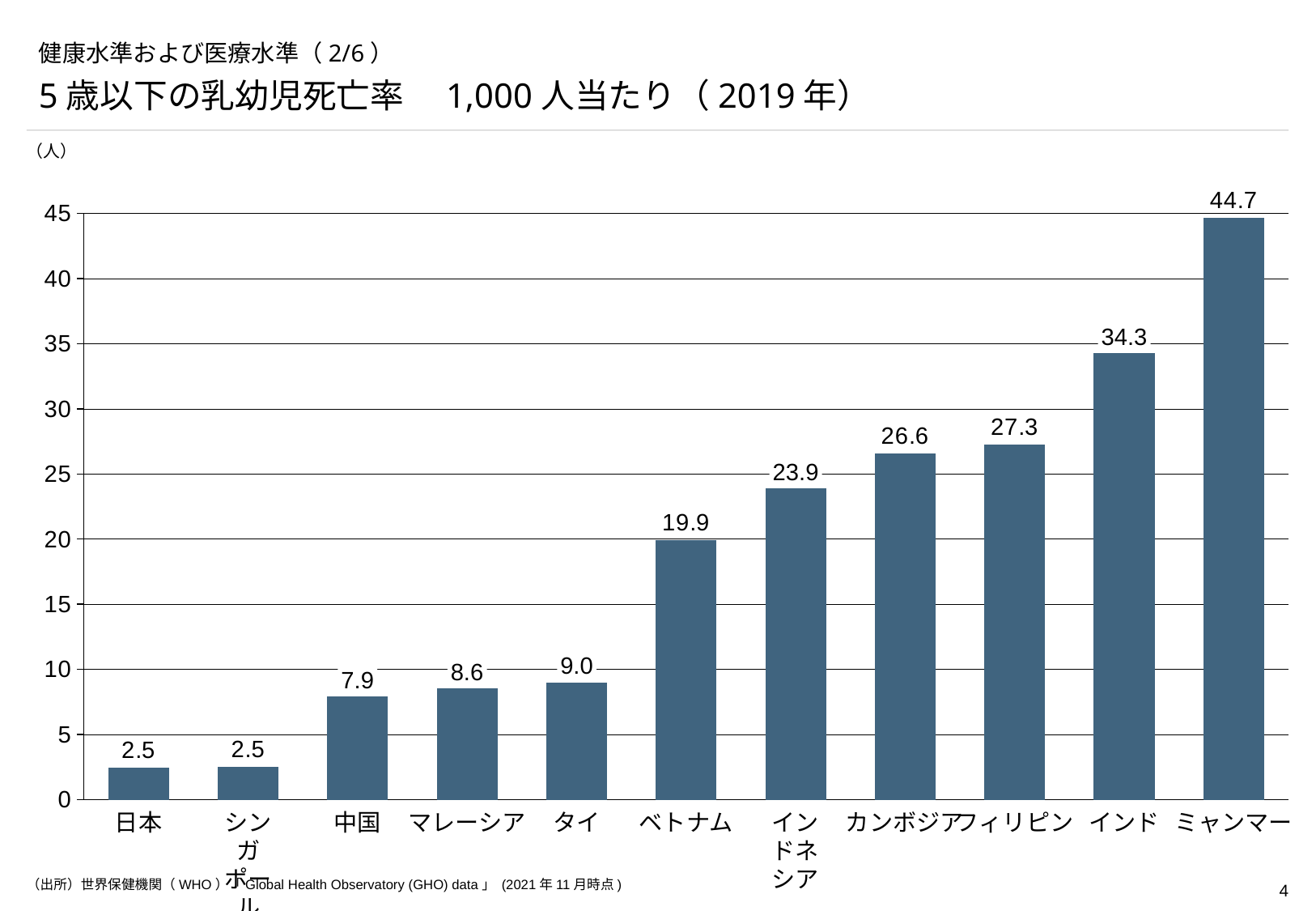
How many countries are shown on the chart? 11 What is the difference between the values for ミャンマー and 日本? 42.2 Which country has the highest value? ミャンマー Which is larger, the value for カンボジア or the value for タイ? カンボジア Do the values rise or fall from left to right along the x axis? rise What is the value for インドネシア? 23.9 What is the value for ベトナム? 19.9 What is the difference between the values for インド and フィリピン? 7.0 What is the value for 中国? 7.9 Is the value for インド greater or less than 30? greater What is the value for ミャンマー? 44.7 What kind of chart is shown on the slide? bar chart